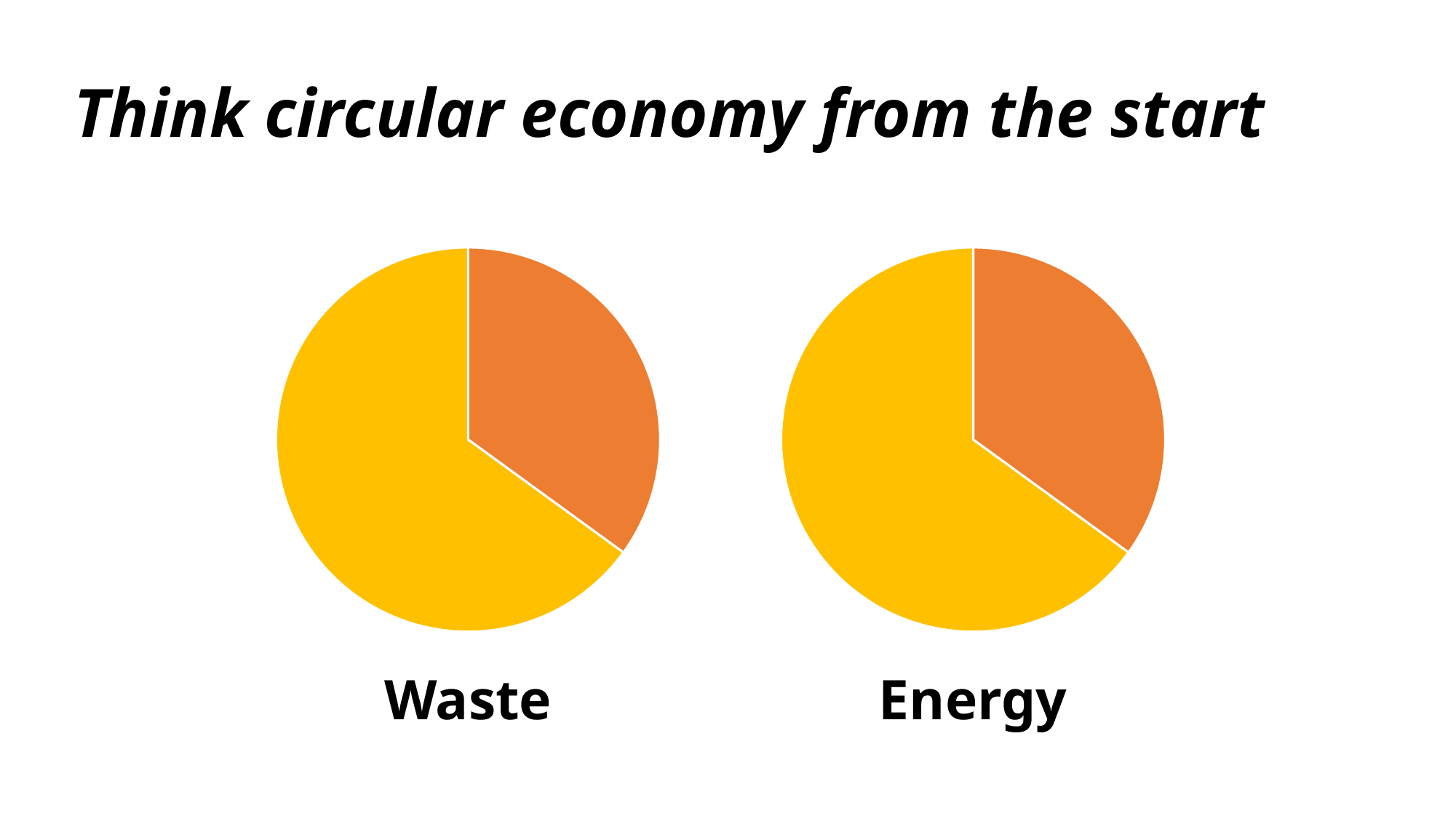
What is the title of the pie chart on the right? Energy In the "Energy" pie chart, which slice is larger, the yellow one or the orange one? The yellow one How many pie charts are shown on the slide? 2 What kind of chart is the chart titled "Waste"? Pie chart In the "Waste" pie chart, which slice is larger, the yellow one or the orange one? The yellow one In the "Energy" pie chart, is the yellow slice greater or less than half of the pie? greater What kind of chart is the chart titled "Energy"? Pie chart What is the title of the pie chart on the left? Waste In the "Waste" pie chart, is the orange slice greater or less than half of the pie? less How many slices does the "Energy" pie chart have? 2 How many slices does the "Waste" pie chart have? 2